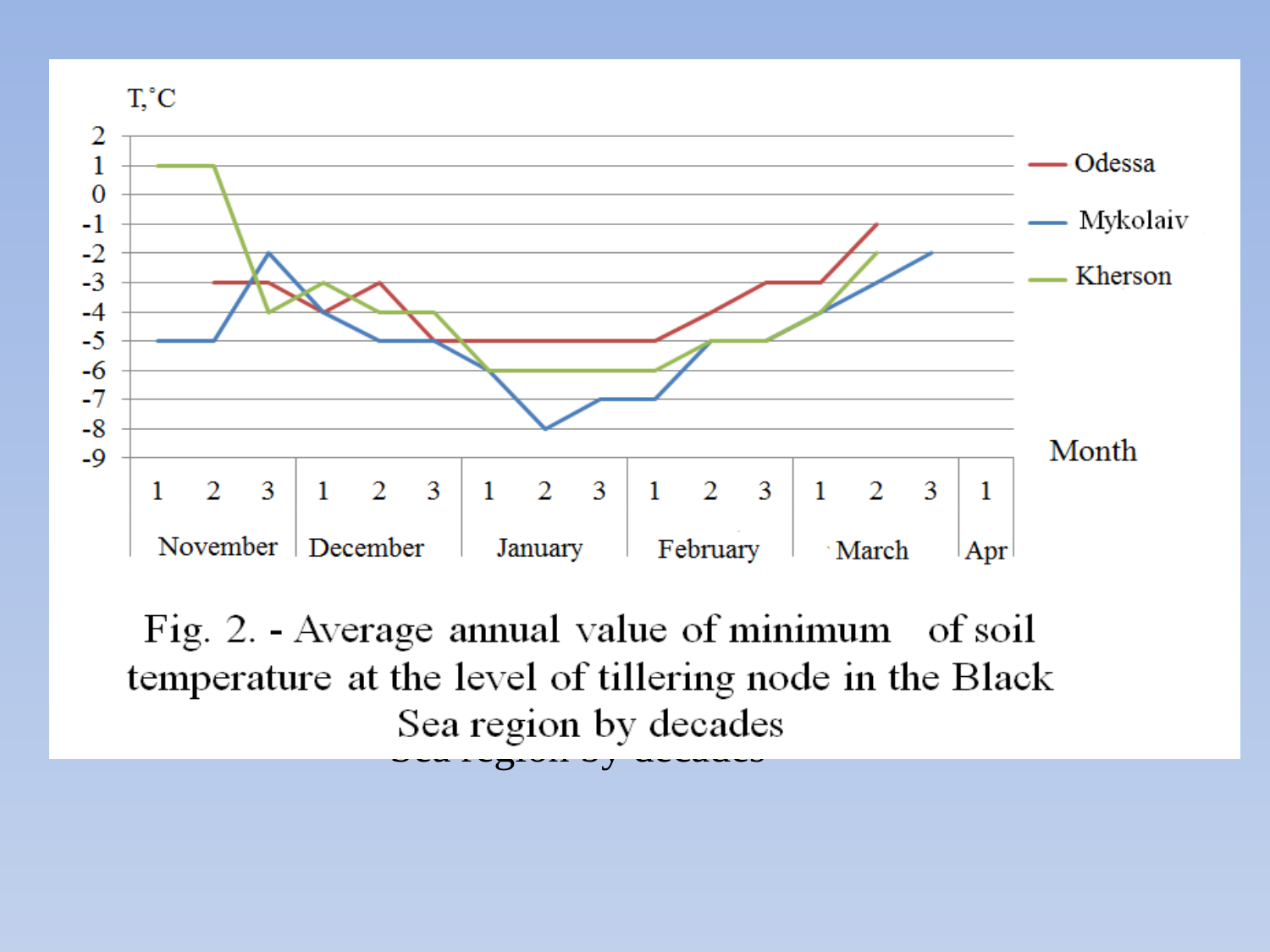
What kind of chart is shown on the slide? line chart In the 2nd decade of January, which is higher, Odessa or Mykolaiv? Odessa Does the Mykolaiv series rise or fall from the 1st decade of February to the 3rd decade of March? rise What colour is the Kherson line in the legend? green Which series reaches the lowest value on the chart? Mykolaiv What is the value for Mykolaiv in the 2nd decade of January? -8 How many months are labelled along the x axis? 6 What is the value for Kherson in the 1st decade of November? 1 What is the value for Odessa in the 2nd decade of March? -1 What is the lowest value reached by the Mykolaiv series? -8 How many series does the legend list? 3 What is the difference between Odessa and Mykolaiv in the 2nd decade of January? 3